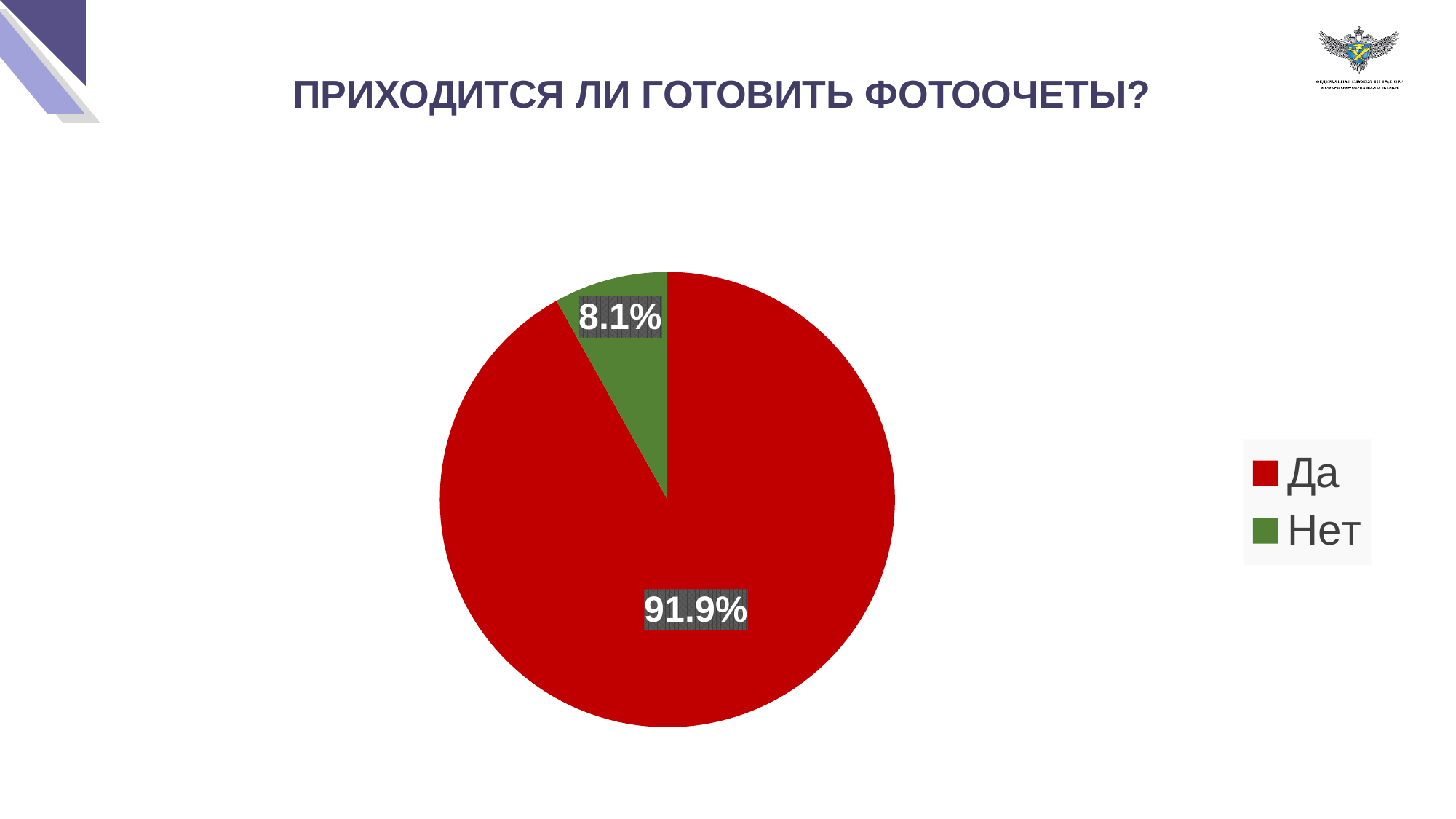
Which category has the largest slice of the pie? Да Which slice is larger, "Да" or "Нет"? Да What is the value shown for the "Да" slice? 91.9% What share of the pie does "Нет" represent? 8.1% What share of the pie does "Да" represent? 91.9% How many slices does the pie chart have? 2 How many entries does the legend list? 2 What is the difference in percentage points between the "Да" and "Нет" slices? 83.8 What kind of chart is shown on the slide? Pie chart What colour is the "Нет" slice? Green Which category has the smallest slice of the pie? Нет What is the value shown for the "Нет" slice? 8.1%